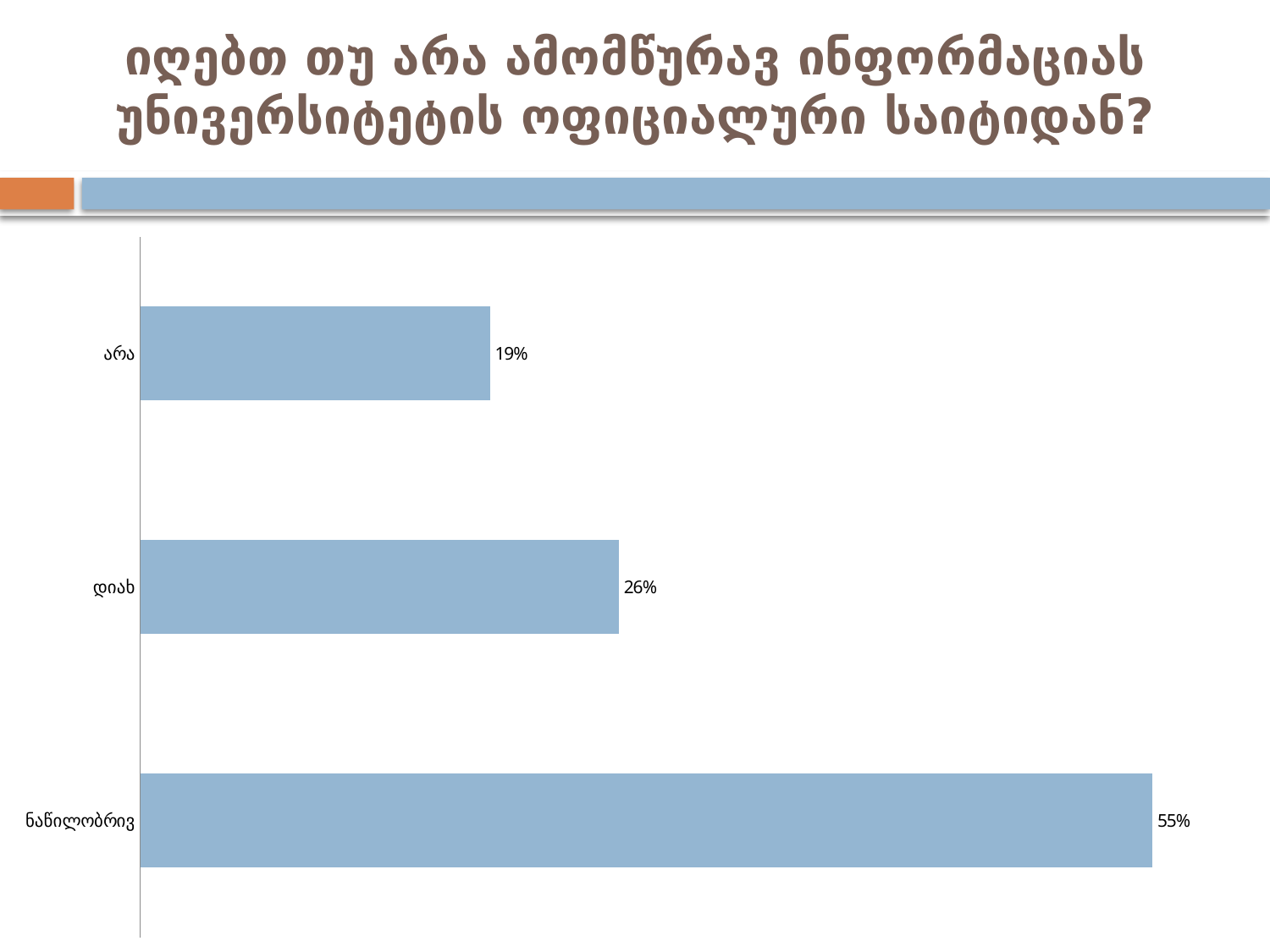
What is the difference between the values for დიახ and არა? 7% What colour are the bars in the chart? light blue What kind of chart is shown on the slide? bar chart How many categories are shown in the chart? 3 What is the value for ნაწილობრივ? 55% What is the value for დიახ? 26% What is the difference between the values for ნაწილობრივ and დიახ? 29% What is the value for არა? 19% What is the total of the three values shown in the chart? 100% Which category has the highest value? ნაწილობრივ Which category has the lowest value? არა Which is larger, the value for დიახ or the value for არა? დიახ